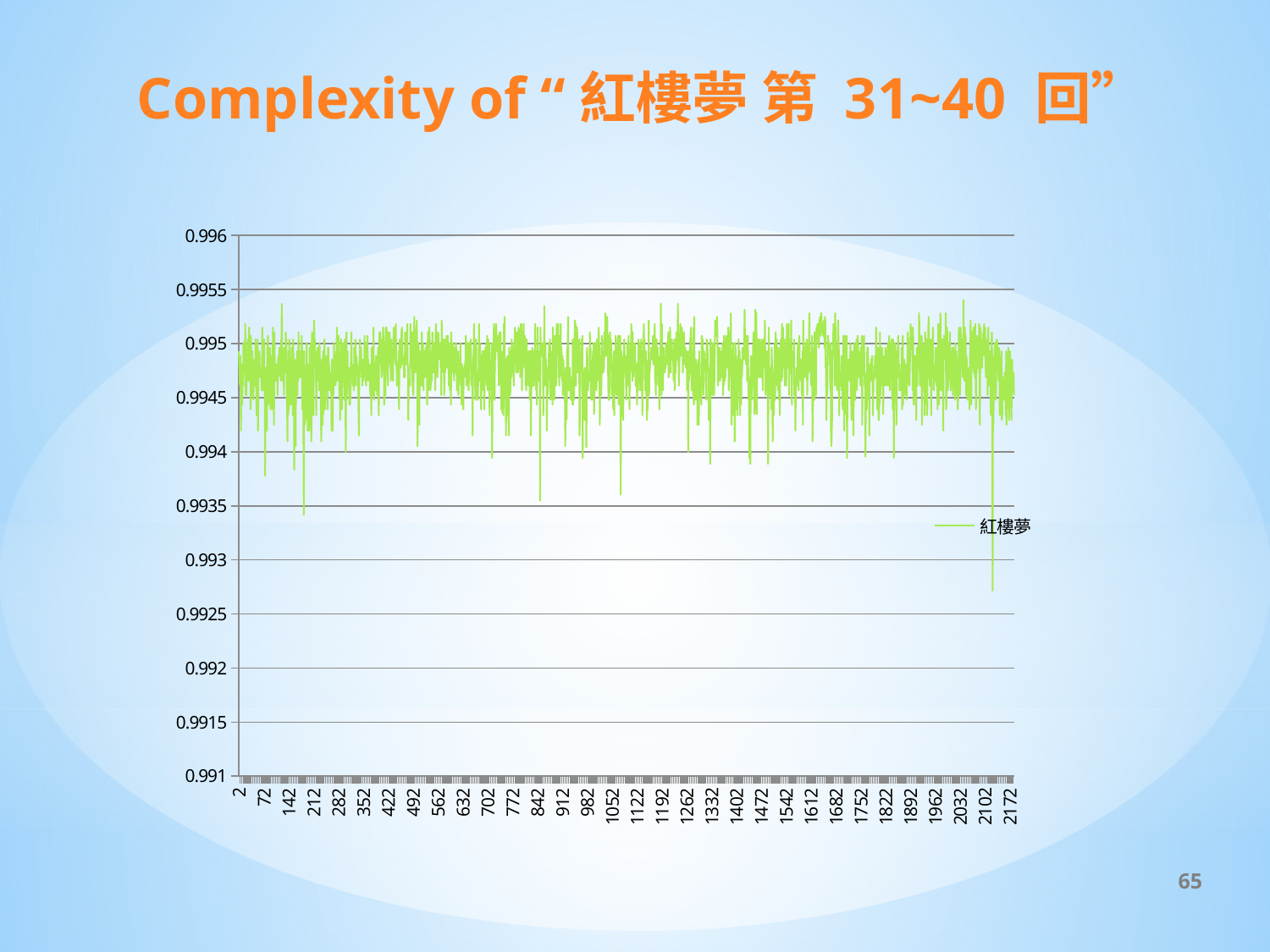
Is the highest point of the 紅樓夢 line greater or less than 0.996? less What kind of chart is shown on the slide? line chart Is the lowest point of the 紅樓夢 line greater or less than 0.9935? less What is the name of the series shown in the legend? 紅樓夢 Near which x-axis label does the 紅樓夢 line reach its lowest value? 2102 What is the title of the slide containing the chart? Complexity of “紅樓夢 第 31~40 回” Do the values of the 紅樓夢 line show a clear rising or falling trend along the x axis? neither; roughly flat What is the highest value shown on the y axis? 0.996 How many series does the legend list? 1 Is the lowest point of the 紅樓夢 line greater or less than 0.993? less